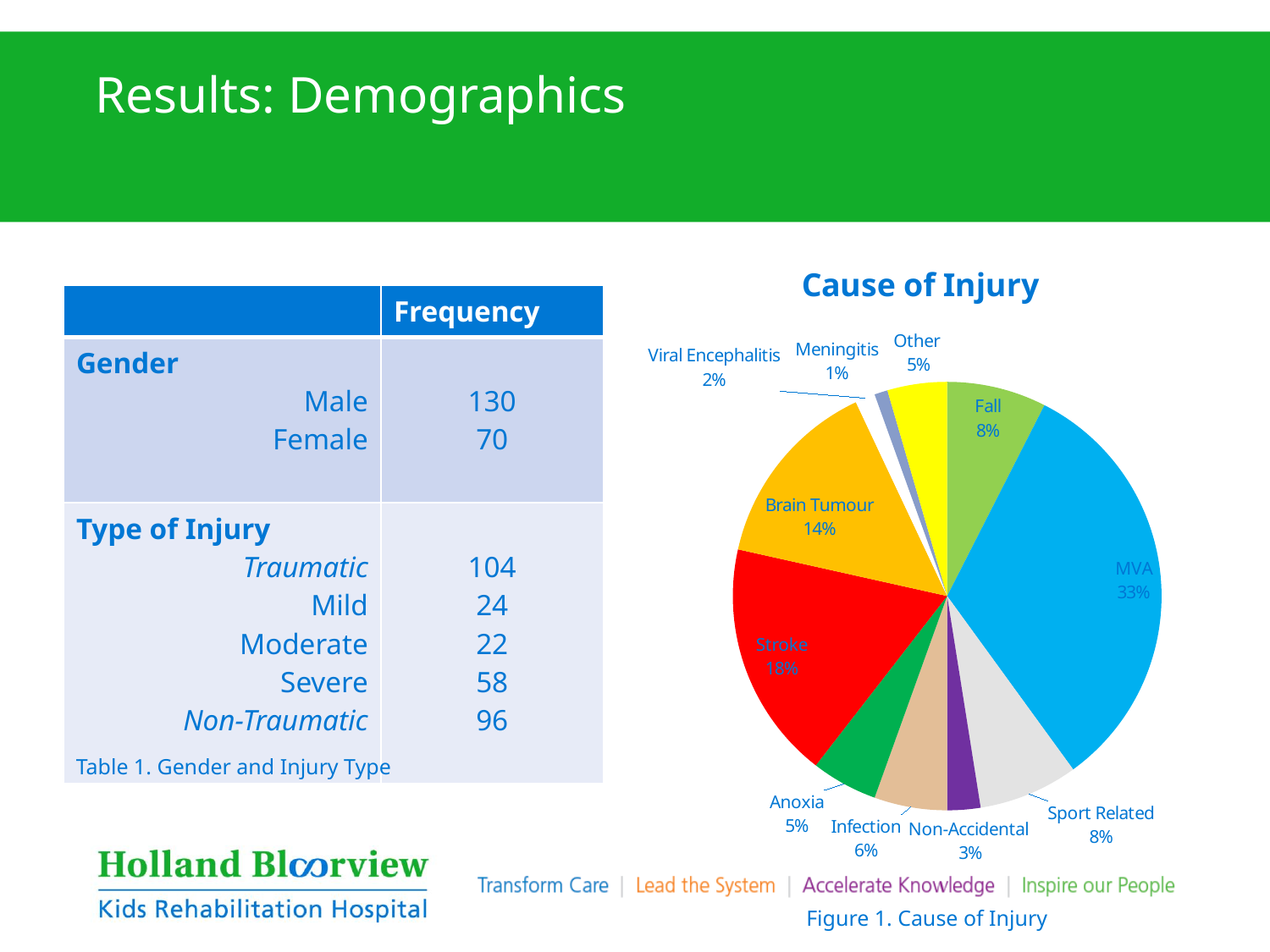
What is the title of the pie chart on the slide? Cause of Injury In the Cause of Injury pie chart, what is the difference in percentage points between MVA and Stroke? 15 In the Cause of Injury pie chart, which cause has the smallest slice? Meningitis In the Cause of Injury pie chart, which is larger, Brain Tumour or Infection? Brain Tumour In the Cause of Injury pie chart, what percentage is labelled for MVA? 33% In the Cause of Injury pie chart, what percentage is labelled for Meningitis? 1% How many slices does the Cause of Injury pie chart have? 11 In the Cause of Injury pie chart, what percentage is labelled for Non-Accidental? 3% In the Cause of Injury pie chart, what percentage is labelled for Stroke? 18% In the Cause of Injury pie chart, which cause has the largest slice? MVA In the Cause of Injury pie chart, what percentage is labelled for Brain Tumour? 14% What type of chart is shown under the title "Cause of Injury"? pie chart